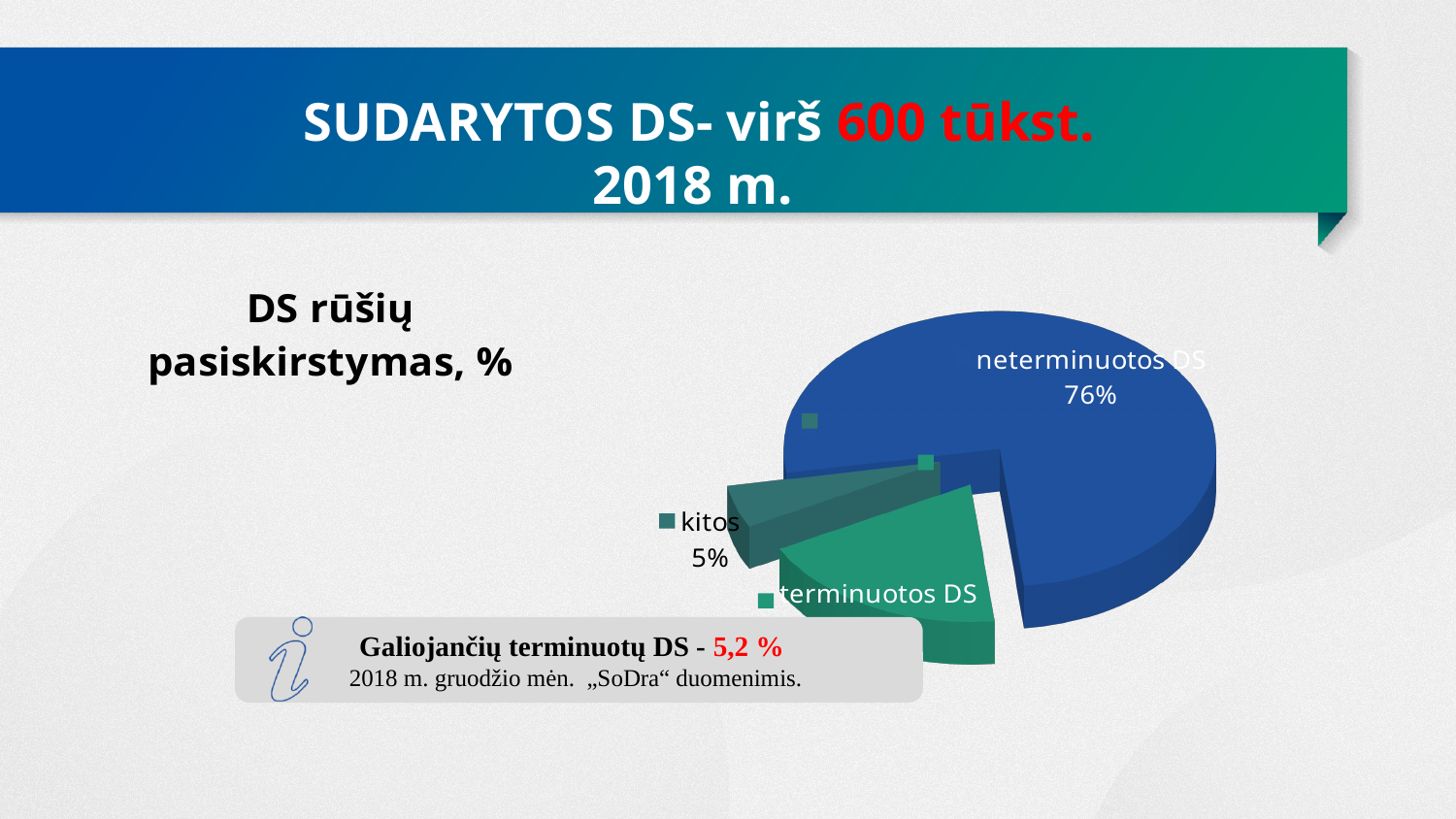
Which category has the largest slice of the pie? neterminuotos DS What share of the pie does the neterminuotos DS slice represent? 76% How many slices does the pie chart have? 3 By how many percentage points does the neterminuotos DS slice exceed the kitos slice? 71 What kind of chart is shown on the slide? pie chart What is the title shown next to the pie chart? DS rūšių pasiskirstymas, % What percentage of the pie is labelled for kitos? 5% What percentage of the pie is labelled for neterminuotos DS? 76% Which slice is larger, neterminuotos DS or kitos? neterminuotos DS Which category has the smallest slice of the pie? kitos What colour is the neterminuotos DS slice? blue Which slice is larger, terminuotos DS or kitos? terminuotos DS